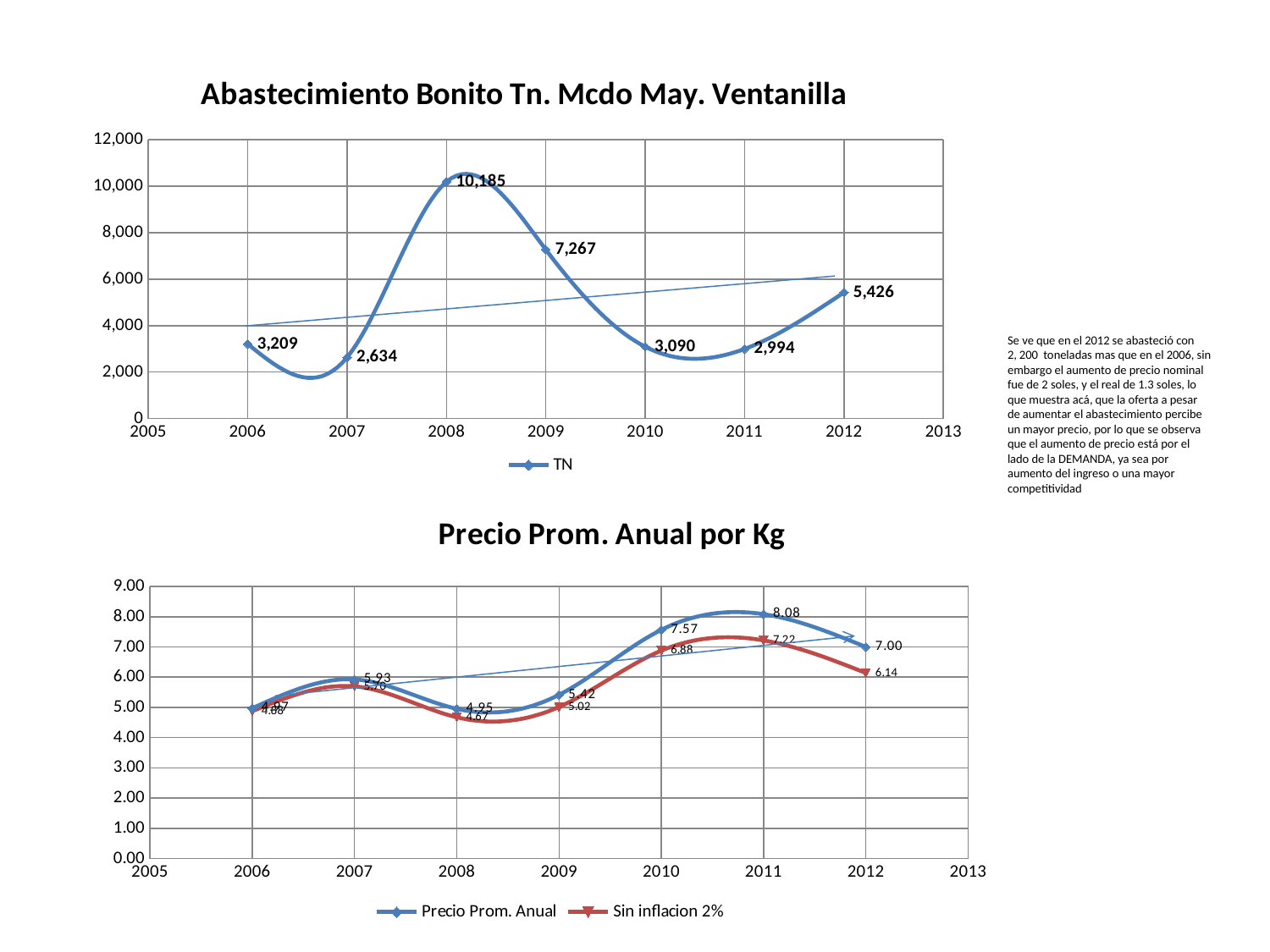
In the 'Abastecimiento Bonito Tn. Mcdo May. Ventanilla' chart, what is the difference between the TN values for 2012 and 2006? 2,217 In the 'Precio Prom. Anual por Kg' chart, what is the 'Precio Prom. Anual' value for 2011? 8.08 What type of chart is 'Precio Prom. Anual por Kg'? Line chart In the 'Abastecimiento Bonito Tn. Mcdo May. Ventanilla' chart, how many data points are plotted for the TN series? 7 In the 'Precio Prom. Anual por Kg' chart, what is the difference between 'Precio Prom. Anual' and 'Sin inflacion 2%' in 2011? 0.86 In the 'Precio Prom. Anual por Kg' chart, what is the 'Sin inflacion 2%' value for 2012? 6.14 In the 'Precio Prom. Anual por Kg' chart, which is larger in 2010: 'Precio Prom. Anual' or 'Sin inflacion 2%'? Precio Prom. Anual How many series does the legend of the 'Precio Prom. Anual por Kg' chart list? 2 In the 'Abastecimiento Bonito Tn. Mcdo May. Ventanilla' chart, what is the TN value for 2008? 10,185 In the 'Abastecimiento Bonito Tn. Mcdo May. Ventanilla' chart, what is the TN value for 2012? 5,426 In the 'Abastecimiento Bonito Tn. Mcdo May. Ventanilla' chart, which year has the lowest TN value? 2007 In the 'Abastecimiento Bonito Tn. Mcdo May. Ventanilla' chart, which year has the highest TN value? 2008